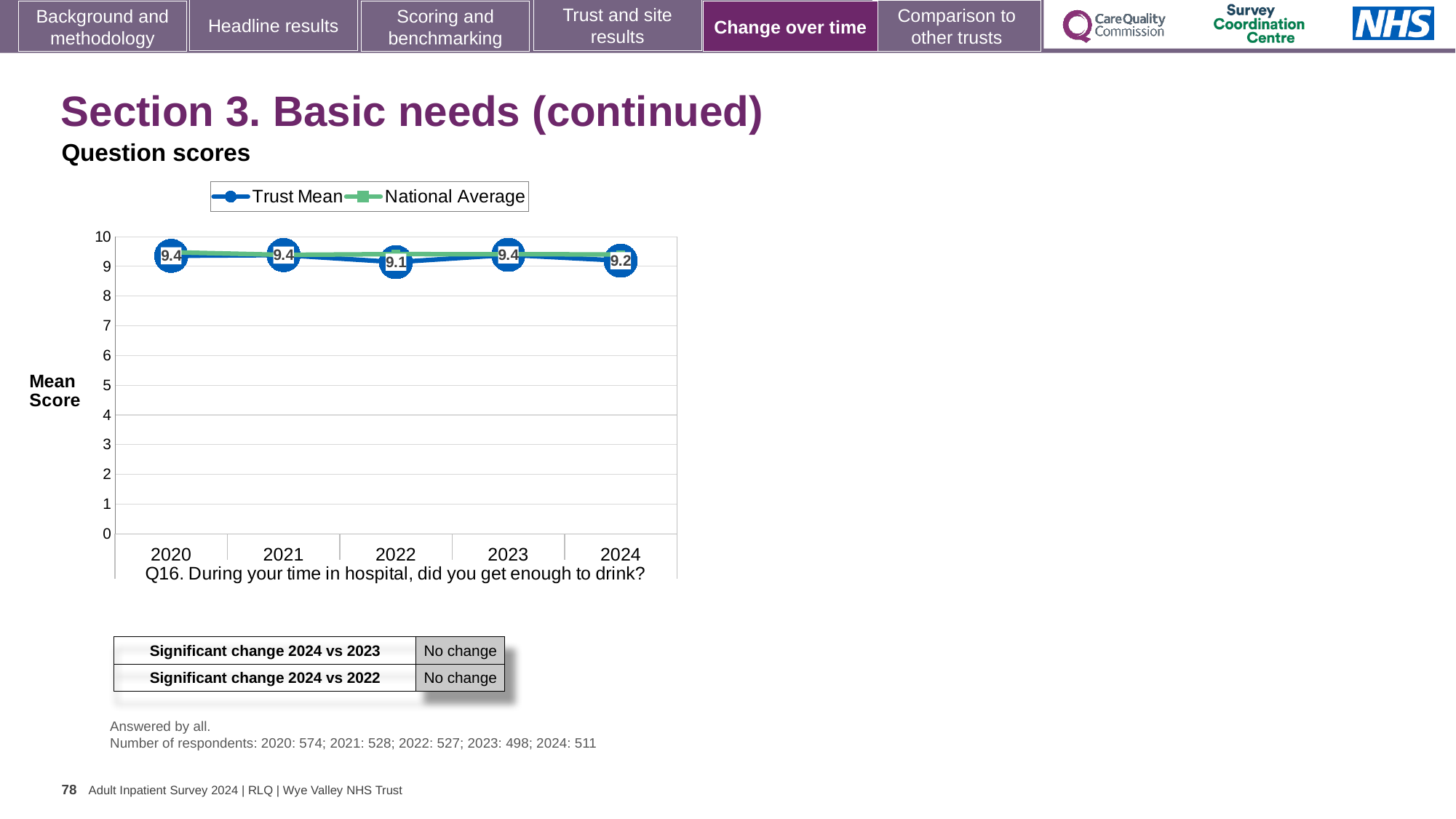
What is the Trust Mean score for 2022? 9.1 Which survey question does the chart show scores for? Q16. During your time in hospital, did you get enough to drink? How many series does the legend list? 2 In which year is the Trust Mean score lowest? 2022 What kind of chart is shown on the slide? line chart Which year has the larger Trust Mean score, 2022 or 2023? 2023 What is the Trust Mean score for 2024? 9.2 Does the Trust Mean score rise or fall from 2023 to 2024? fall What is the Trust Mean score for 2020? 9.4 How many years are plotted on the x axis? 5 What is the difference between the Trust Mean scores for 2023 and 2022? 0.3 Is the Trust Mean score for 2024 greater or less than 5? greater